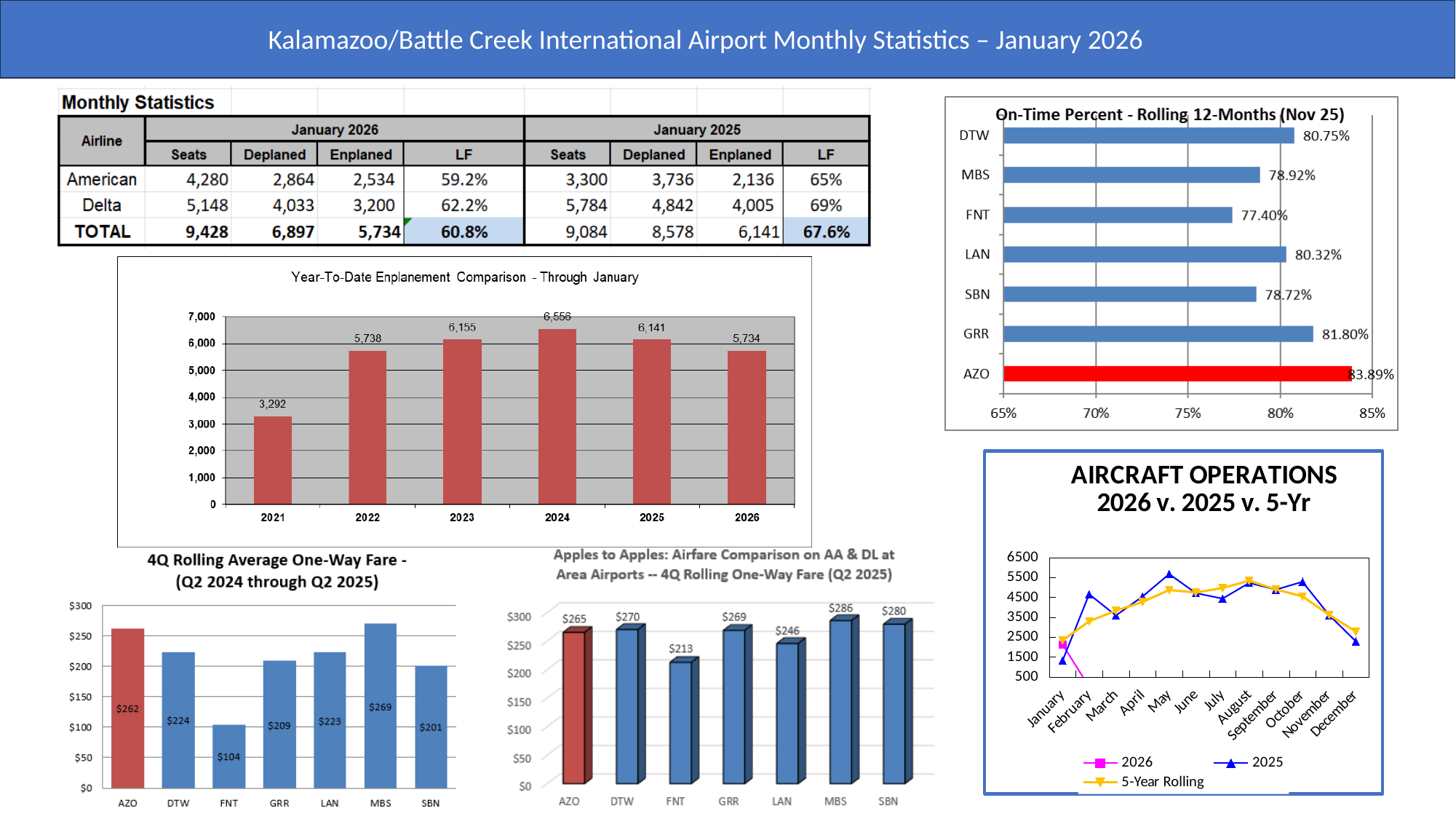
In the Aircraft Operations 2026 v. 2025 v. 5-Yr chart, is the 2025 value for January greater or less than 2500? less In the On-Time Percent - Rolling 12-Months (Nov 25) chart, which is larger, the value for DTW or the value for LAN? DTW In the On-Time Percent - Rolling 12-Months (Nov 25) chart, which airport has the highest on-time percent? AZO In the Year-To-Date Enplanement Comparison chart, what is the difference between the 2025 and 2026 values? 407 In the 4Q Rolling Average One-Way Fare chart, what is the fare for FNT? $104 In the Apples to Apples airfare comparison chart, what is the difference between the MBS fare and the AZO fare? $21 In the On-Time Percent - Rolling 12-Months (Nov 25) chart, what is the value for FNT? 77.40% In the Year-To-Date Enplanement Comparison chart, how many years are plotted? 6 In the Year-To-Date Enplanement Comparison chart, what is the value for 2024? 6,556 In the Aircraft Operations 2026 v. 2025 v. 5-Yr chart, how many series does the legend list? 3 In the 4Q Rolling Average One-Way Fare chart, which airport has the highest fare? MBS In the Year-To-Date Enplanement Comparison chart, which year has the lowest value? 2021